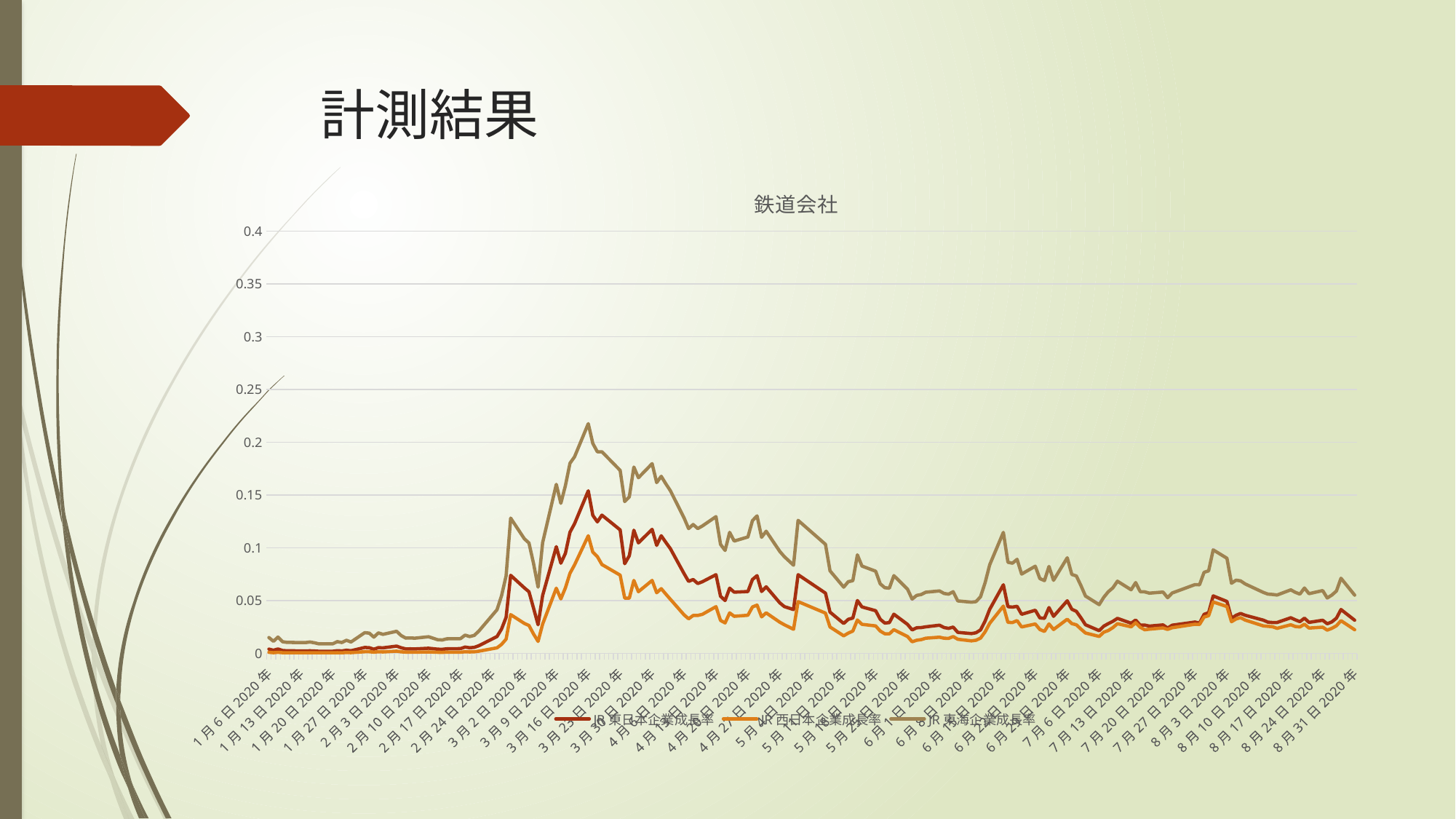
What is the highest tick value shown on the vertical axis? 0.4 What kind of chart is shown on the slide? line chart Is the peak value of JR 東海企業成長率 greater or less than 0.15? greater How many series does the chart's legend list? 3 Is the peak value of JR 西日本企業成長率 greater or less than 0.15? less Which series stays lowest across most of the chart? JR 西日本企業成長率 How do the values change from the March 2020 peak to the end of August 2020? they fall Which series reaches the highest peak in the chart? JR 東海企業成長率 Around 3月23日2020年, which series is higher: JR 東日本企業成長率 or JR 西日本企業成長率? JR 東日本企業成長率 Is the value for JR 東海企業成長率 at 1月6日2020年 greater or less than 0.05? less How do the values change from January to the peak in March 2020? they rise What is the title of the chart? 鉄道会社